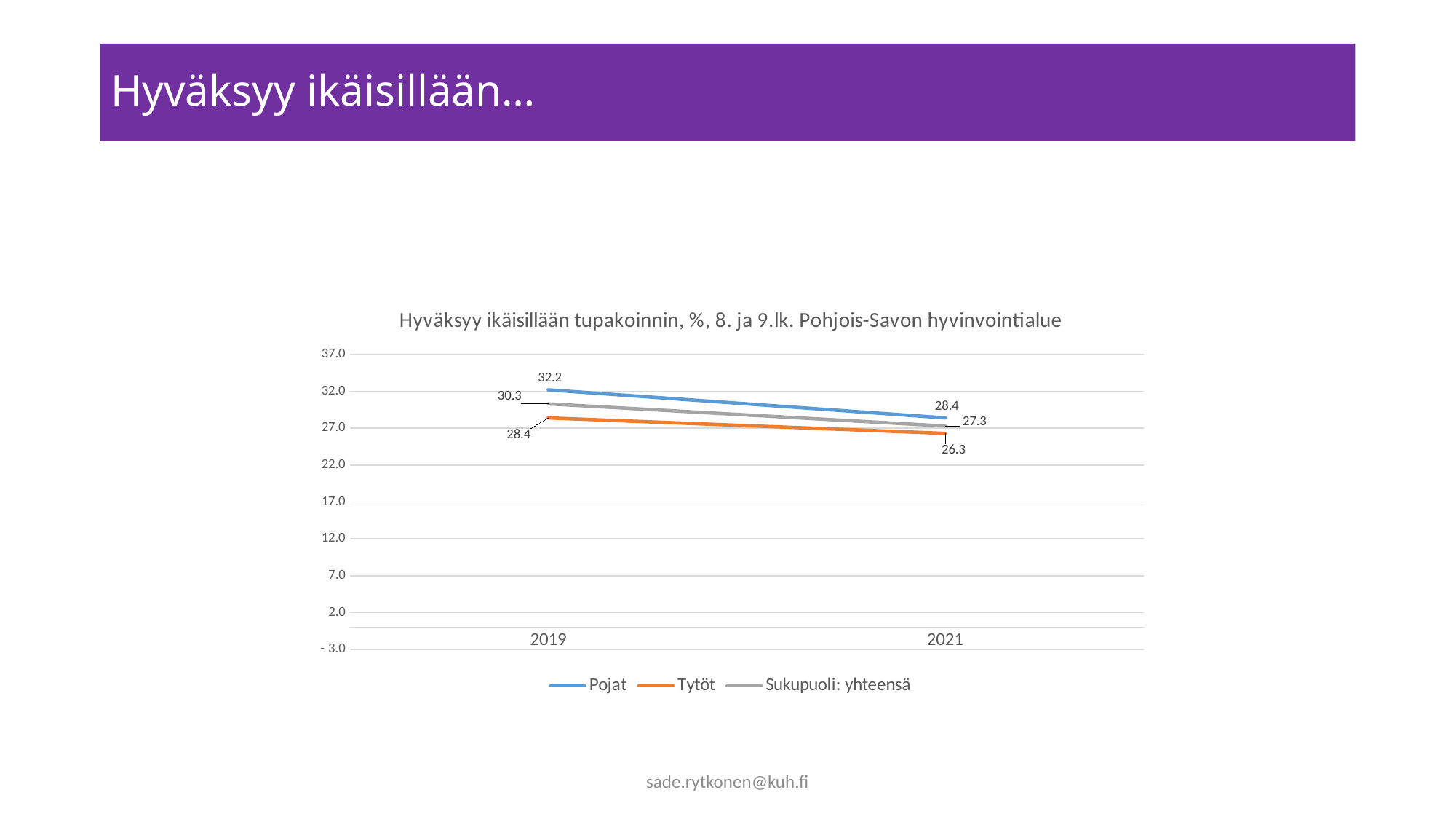
What kind of chart is shown? line chart By how much did the value for Pojat fall from 2019 to 2021? 3.8 Which series has the lowest value in 2021? Tytöt What is the value for Sukupuoli: yhteensä in 2019? 30.3 What is the value for Pojat in 2021? 28.4 What is the difference between Pojat and Tytöt in 2021? 2.1 What is the value for Pojat in 2019? 32.2 How many series does the legend list? 3 Which series has the highest value in 2019? Pojat Which is larger: Tytöt in 2019 or Sukupuoli: yhteensä in 2021? Tytöt in 2019 Does the value for Sukupuoli: yhteensä rise or fall from 2019 to 2021? fall What is the value for Tytöt in 2021? 26.3